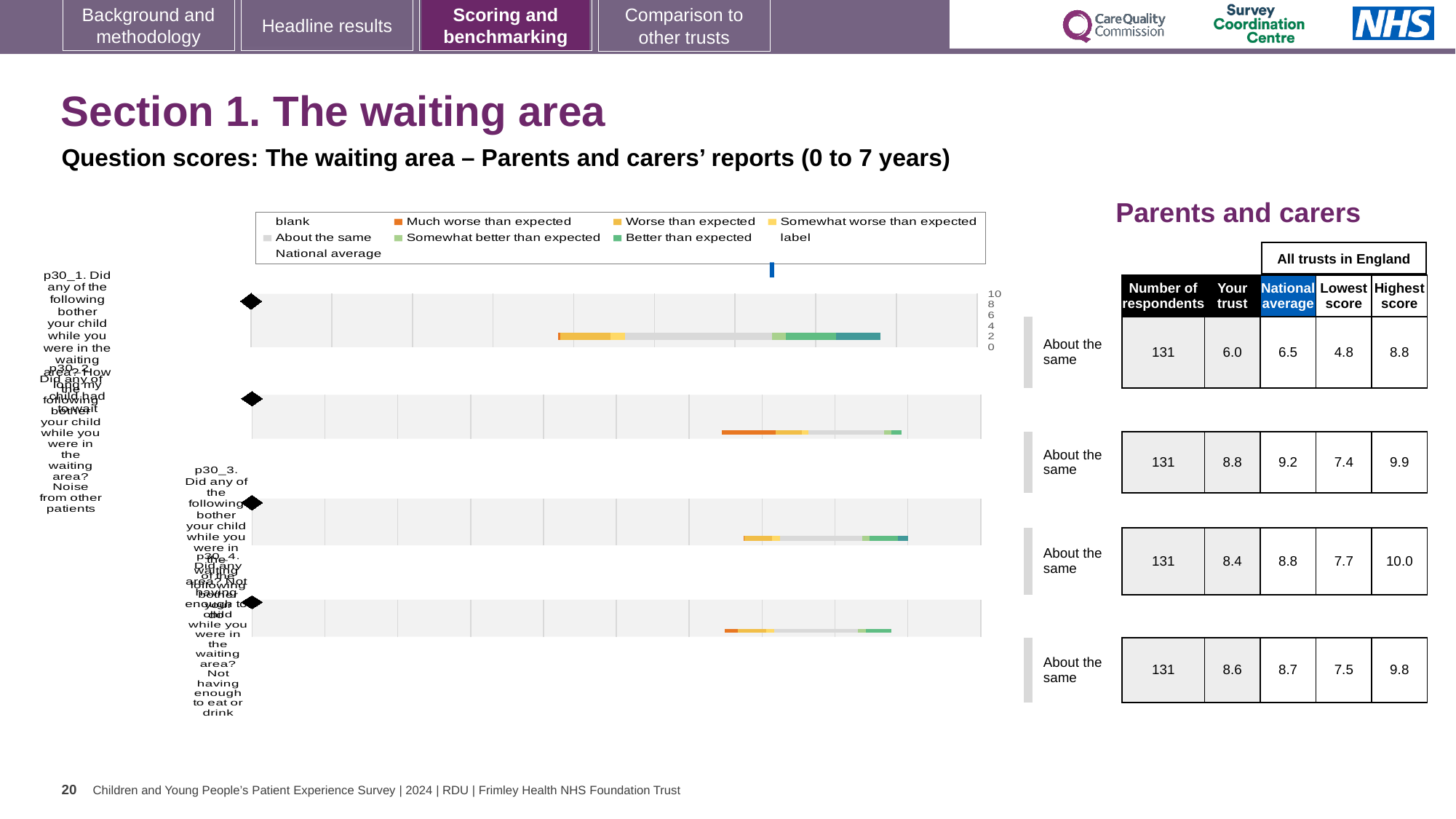
In the table beside the charts, which question has the highest 'Your trust' score? p30_2 In the table beside the charts, what is the 'Your trust' score for p30_1 (Did any of the following bother your child while you were in the waiting area? How long my child had to wait)? 6.0 In the table beside the charts, what is the Highest score for p30_3? 10.0 In the table beside the charts, what is the number of respondents for p30_2? 131 In the chart legend, what colour represents 'Much worse than expected'? orange In the table beside the charts, what is the difference between the National average (6.5) and Your trust (6.0) for p30_1? 0.5 How many survey questions (p30_1 to p30_4) have a bar chart on this slide? 4 What kind of chart is used to show the question scores on this slide? bar chart In the chart legend, what colour represents 'Better than expected'? teal What benchmark category is shown next to each of the four charts? About the same In the table beside the charts, for p30_3 is the 'Your trust' score or the 'National average' larger? National average In the table beside the charts, which question has the lowest 'Your trust' score? p30_1